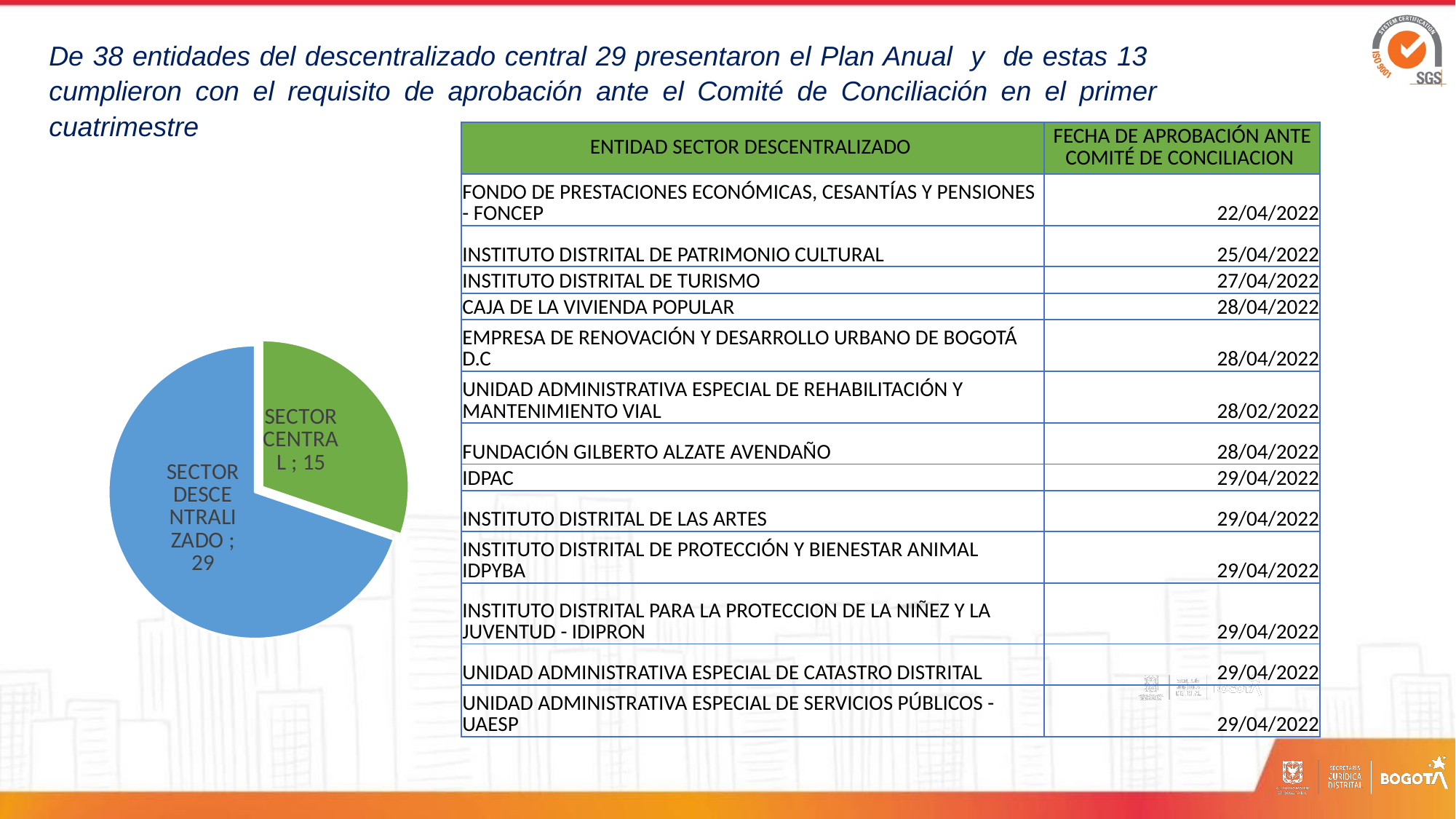
What is the difference between the values for SECTOR DESCENTRALIZADO and SECTOR CENTRAL in the pie chart? 14 Which slice of the pie chart is the smallest? SECTOR CENTRAL How many slices does the pie chart have? 2 What is the value for SECTOR CENTRAL in the pie chart? 15 Which is larger in the pie chart, SECTOR CENTRAL or SECTOR DESCENTRALIZADO? SECTOR DESCENTRALIZADO What kind of chart is shown on the slide? pie chart What colour is the SECTOR DESCENTRALIZADO slice in the pie chart? blue Which slice of the pie chart is the largest? SECTOR DESCENTRALIZADO What is the value for SECTOR DESCENTRALIZADO in the pie chart? 29 What is the total of the two slices in the pie chart? 44 What colour is the SECTOR CENTRAL slice in the pie chart? green